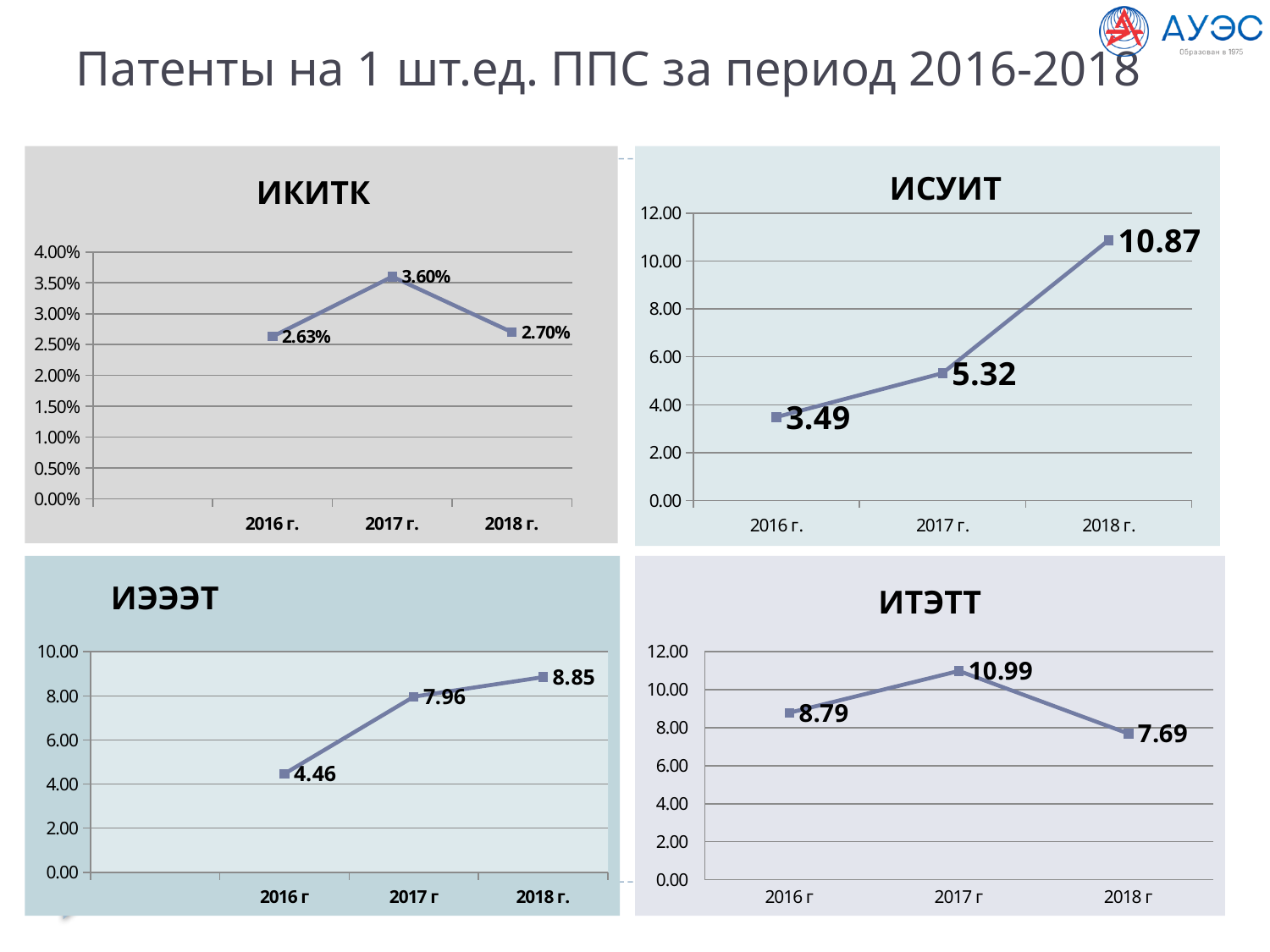
In the ИСУИТ chart, what is the difference between the 2018 г. and 2016 г. values? 7.38 In the ИЭЭЭТ chart, what is the value for 2016 г? 4.46 In the ИКИТК chart, which year has the lowest value? 2016 г. In the ИЭЭЭТ chart, which year has the highest value? 2018 г. In the ИКИТК chart, what is the value for 2017 г.? 3.60% How many data points are plotted in the ИКИТК chart? 3 What kind of chart is the ИСУИТ chart? line chart In the ИТЭТТ chart, what is the value for 2017 г? 10.99 In the ИСУИТ chart, do the values rise or fall from 2016 г. to 2018 г.? rise In the ИТЭТТ chart, what is the difference between the 2017 г and 2018 г values? 3.30 In the ИТЭТТ chart, which is larger, the value for 2016 г or the value for 2018 г? 2016 г In the ИСУИТ chart, what is the value for 2018 г.? 10.87